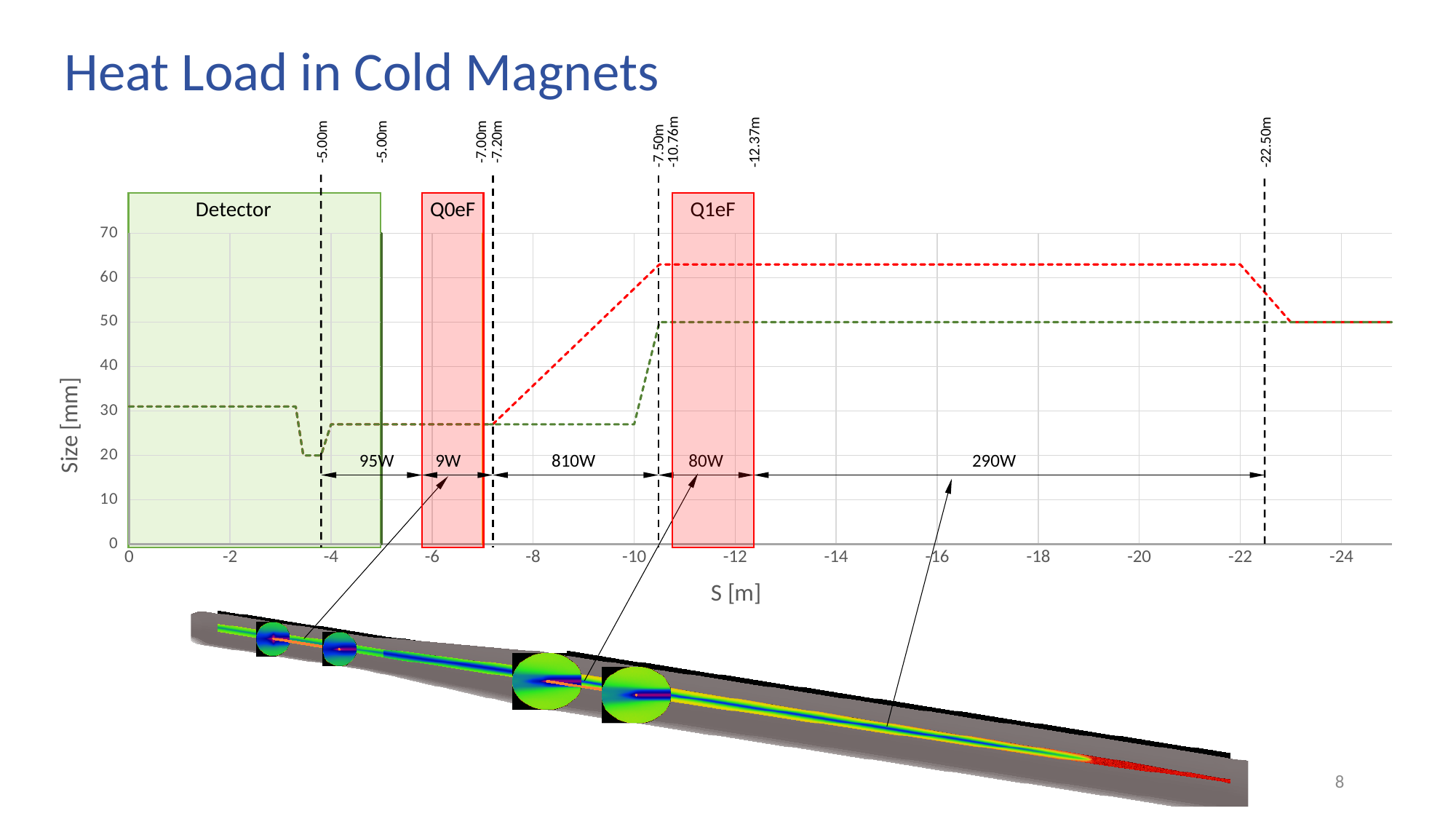
What is the label of the vertical axis of the chart? Size [mm] What kind of chart is shown on the slide? line chart What heat load is annotated for the Q1eF region? 80W What heat load is annotated for the Q0eF region? 9W Is the value of the red dashed line at S = -8 greater or less than 40? less How many heat load values are annotated along the chart? 5 Is the value of the red dashed line at S = -16 greater or less than 60? greater Which annotated segment has the lowest heat load? 9W What is the title of the slide? Heat Load in Cold Magnets Which annotated segment has the highest heat load? 810W Which is larger, the 95W heat load or the 80W heat load? 95W What is the difference between the 810W segment and the 80W segment? 730W